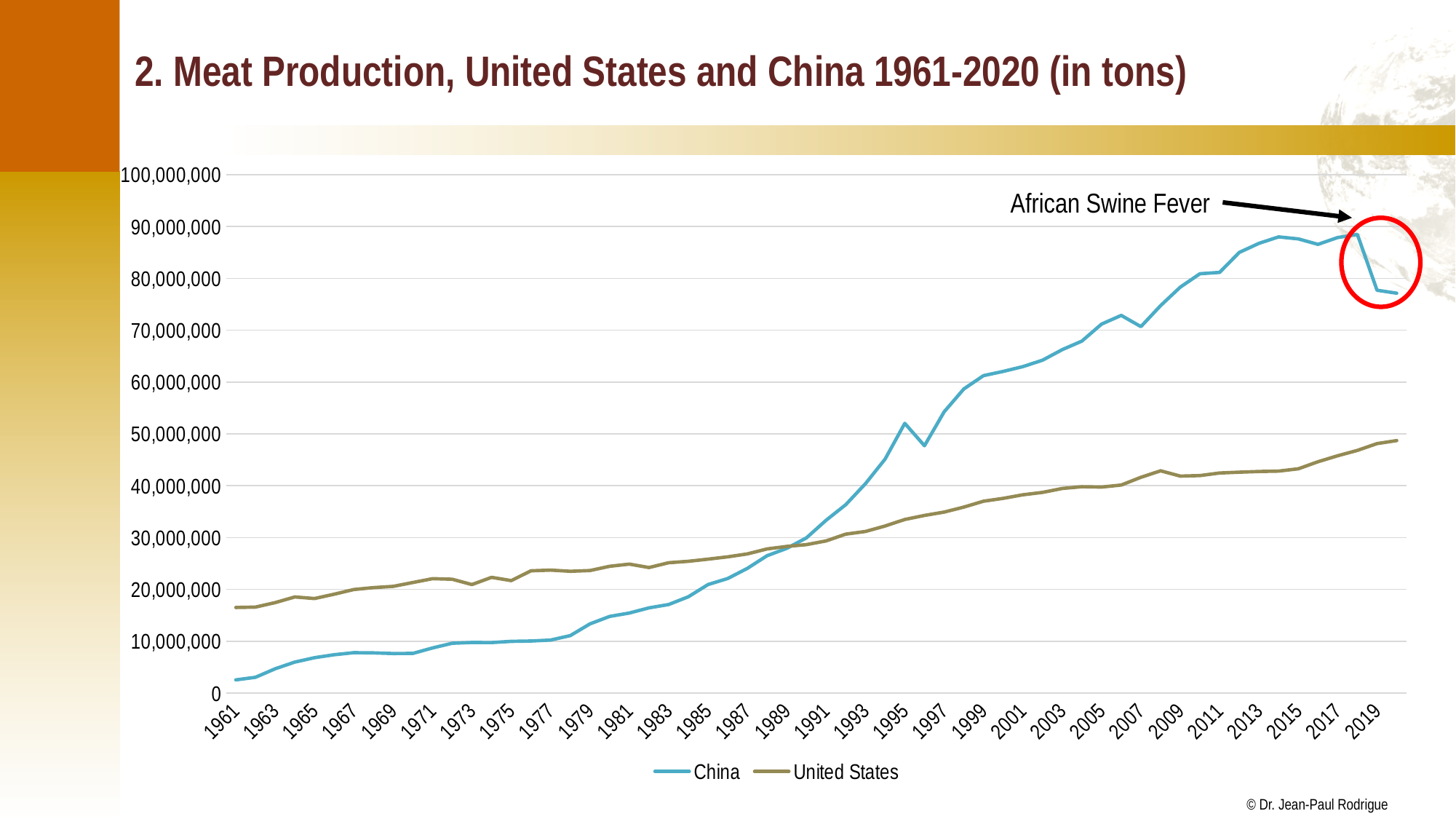
Is the value for United States in 2019 greater or less than 40,000,000? greater Is the value for China in 1961 greater or less than 10,000,000? less Which series has the larger value in 1975, China or United States? United States Which two series are plotted in the chart? China and United States What kind of chart is shown on the slide? Line chart Is the value for United States in 1961 greater or less than 10,000,000? greater What event does the annotation with the arrow and red circle point to at the end of the China line? African Swine Fever Does the United States line generally rise or fall from 1961 to 2020? rise How many series does the legend list? 2 Which series has the larger value in 2019, China or United States? China